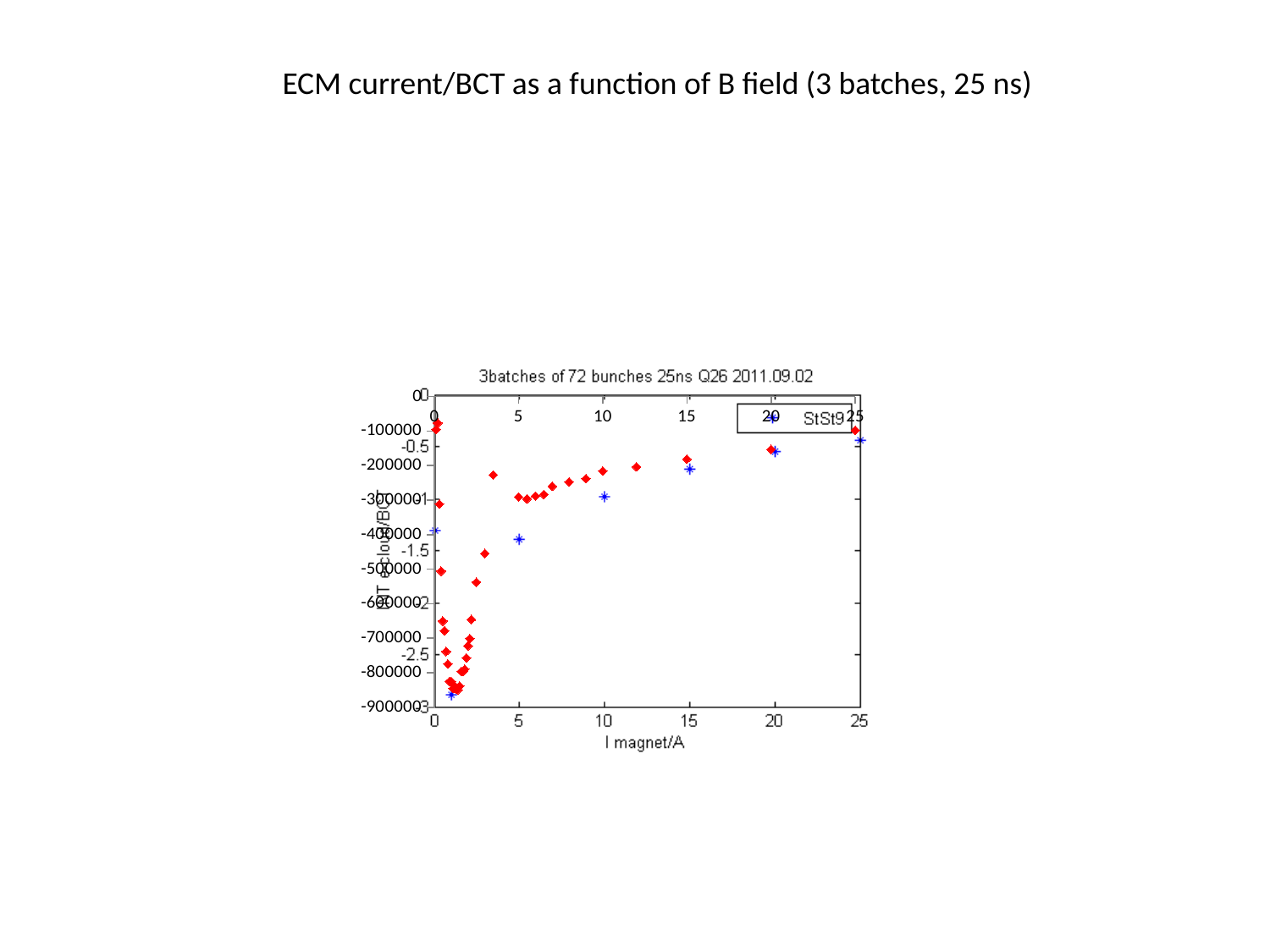
Is the red diamond value at I magnet = 20 A greater or less than -200000? greater What is the x-axis label of the chart? I magnet/A Which is larger, the blue asterisk value at I magnet = 5 A or at I magnet = 25 A? 25 A What entry does the legend box in the chart list? StSt9 Is the blue asterisk value at I magnet = 1 A greater or less than -2.5? less How many blue asterisk points are plotted in the chart? 7 How many entries does the legend box list? 1 Is the red diamond value at I magnet = 10 A greater or less than -200000? less What kind of chart is shown on the slide? Scatter plot From I magnet = 5 A to 25 A, do the blue asterisk values rise or fall? rise